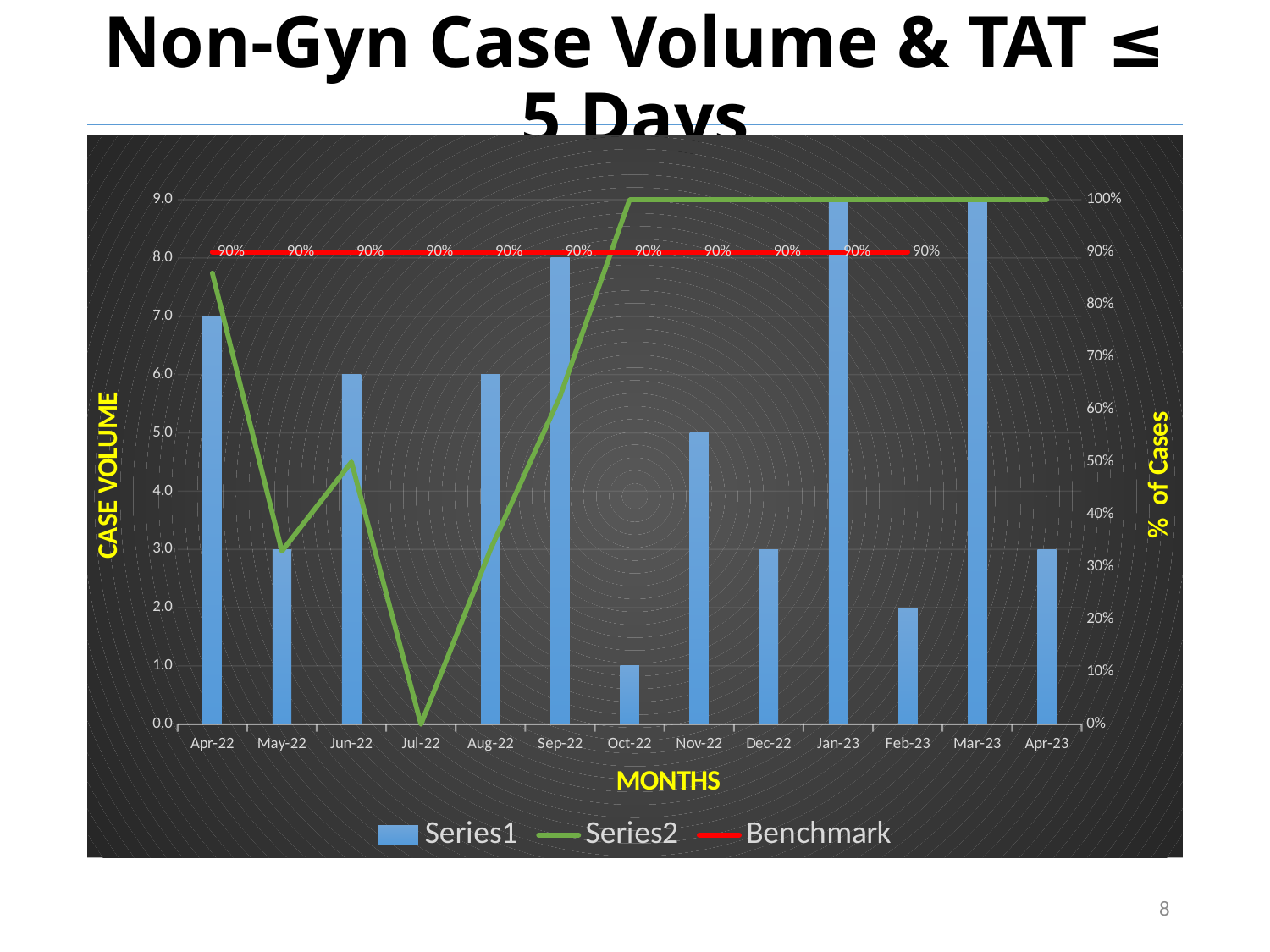
What is the Series2 value for Oct-22? 100% What is the case volume (Series1) for Sep-22? 8.0 What is the difference in case volume between Sep-22 and Apr-22? 1.0 Which month has the larger case volume, Nov-22 or Dec-22? Nov-22 What is the case volume (Series1) for Feb-23? 2.0 Does the Series2 line rise or fall from Jul-22 to Oct-22? rise What is the case volume (Series1) for Apr-22? 7.0 What kind of chart is this? Combination bar and line chart How many months are shown on the x axis? 13 How many series does the legend list? 3 What value does the Benchmark line show for each month? 90% Is the Series2 value for May-22 greater or less than 40%? less